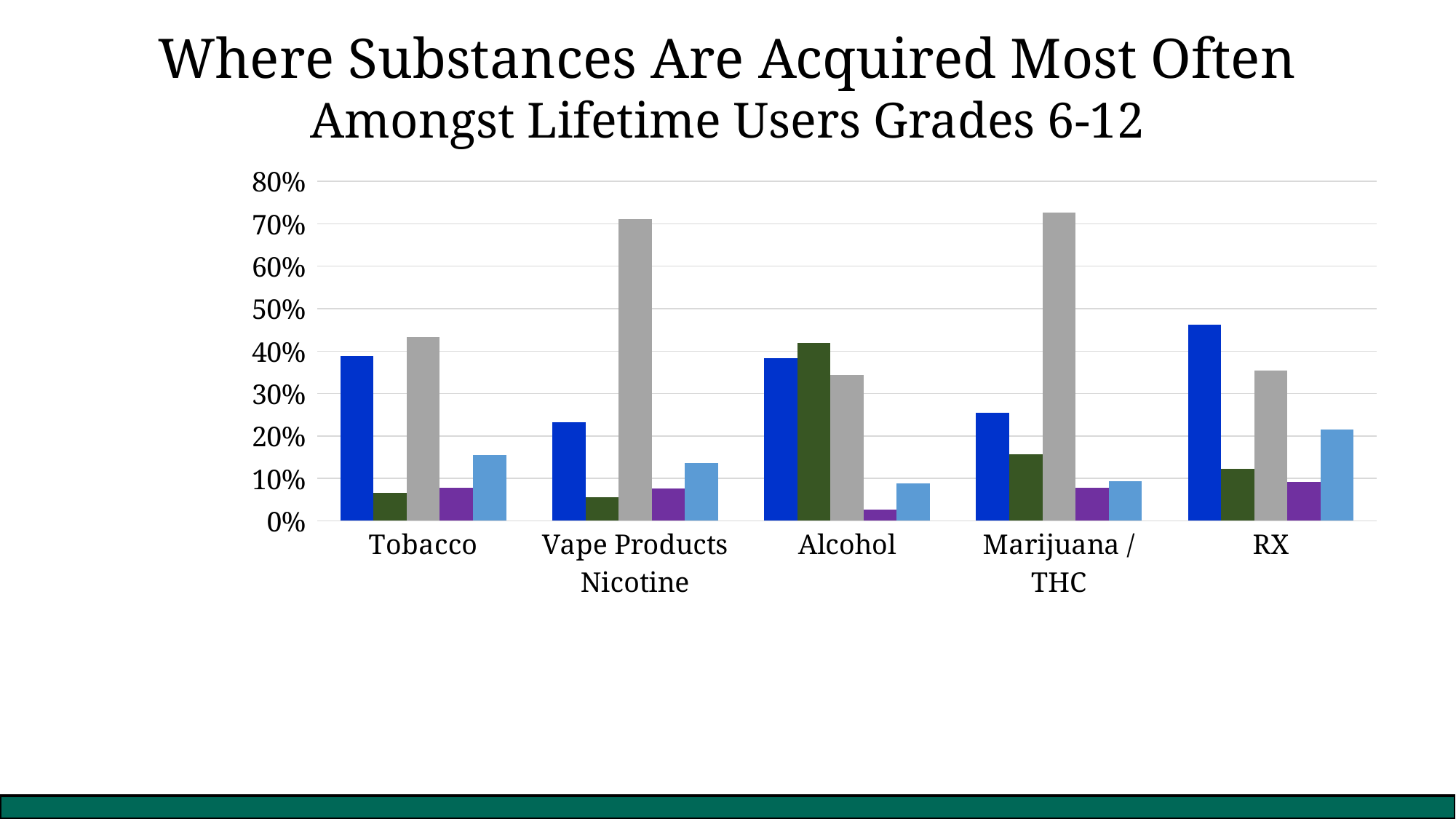
Is the gray bar for Marijuana / THC greater or less than 70%? greater Is the dark blue bar for Marijuana / THC greater or less than 30%? less Which substance category has the shortest purple bar? Alcohol How many substance categories are shown on the x axis? 5 Is the gray bar for Vape Products Nicotine greater or less than 60%? greater Which substance category has the tallest dark blue bar? RX How many bars are plotted for each substance category? 5 For Alcohol, which bar is taller: the dark green bar or the gray bar? the dark green bar What is the title of the chart? Where Substances Are Acquired Most Often Amongst Lifetime Users Grades 6-12 What kind of chart is shown on the slide? bar chart